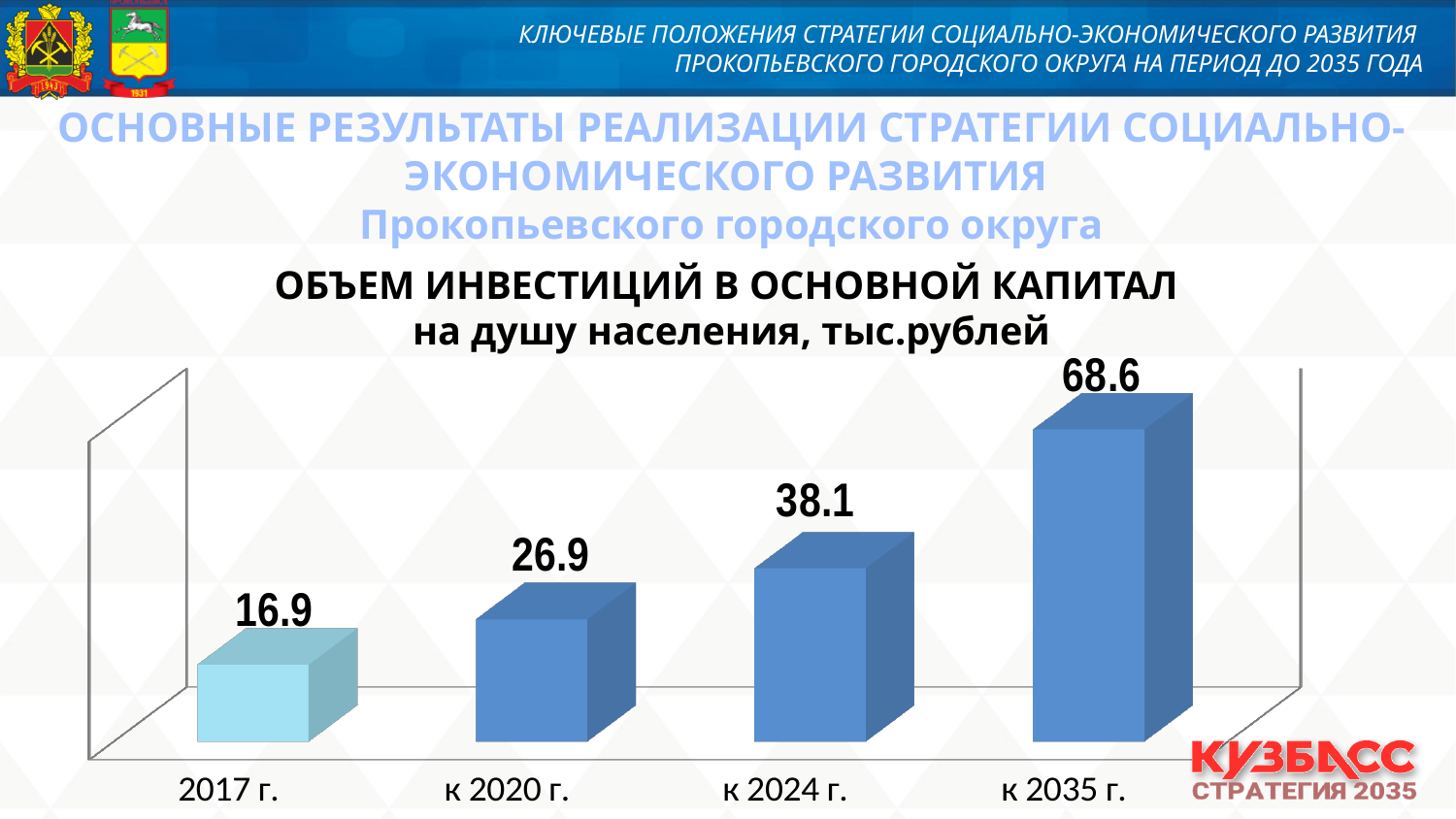
Which category has the lowest value? 2017 г. What kind of chart is this? bar chart Which is larger, the value for к 2020 г. or the value for к 2024 г.? к 2024 г. What is the value for к 2035 г.? 68.6 What is the value for 2017 г.? 16.9 What is the value for к 2020 г.? 26.9 What is the difference between the values for к 2024 г. and к 2020 г.? 11.2 What is the value for к 2024 г.? 38.1 How many categories are shown on the chart? 4 Do the values rise or fall from 2017 г. to к 2035 г.? rise Which category has the highest value? к 2035 г. What is the difference between the values for к 2035 г. and 2017 г.? 51.7